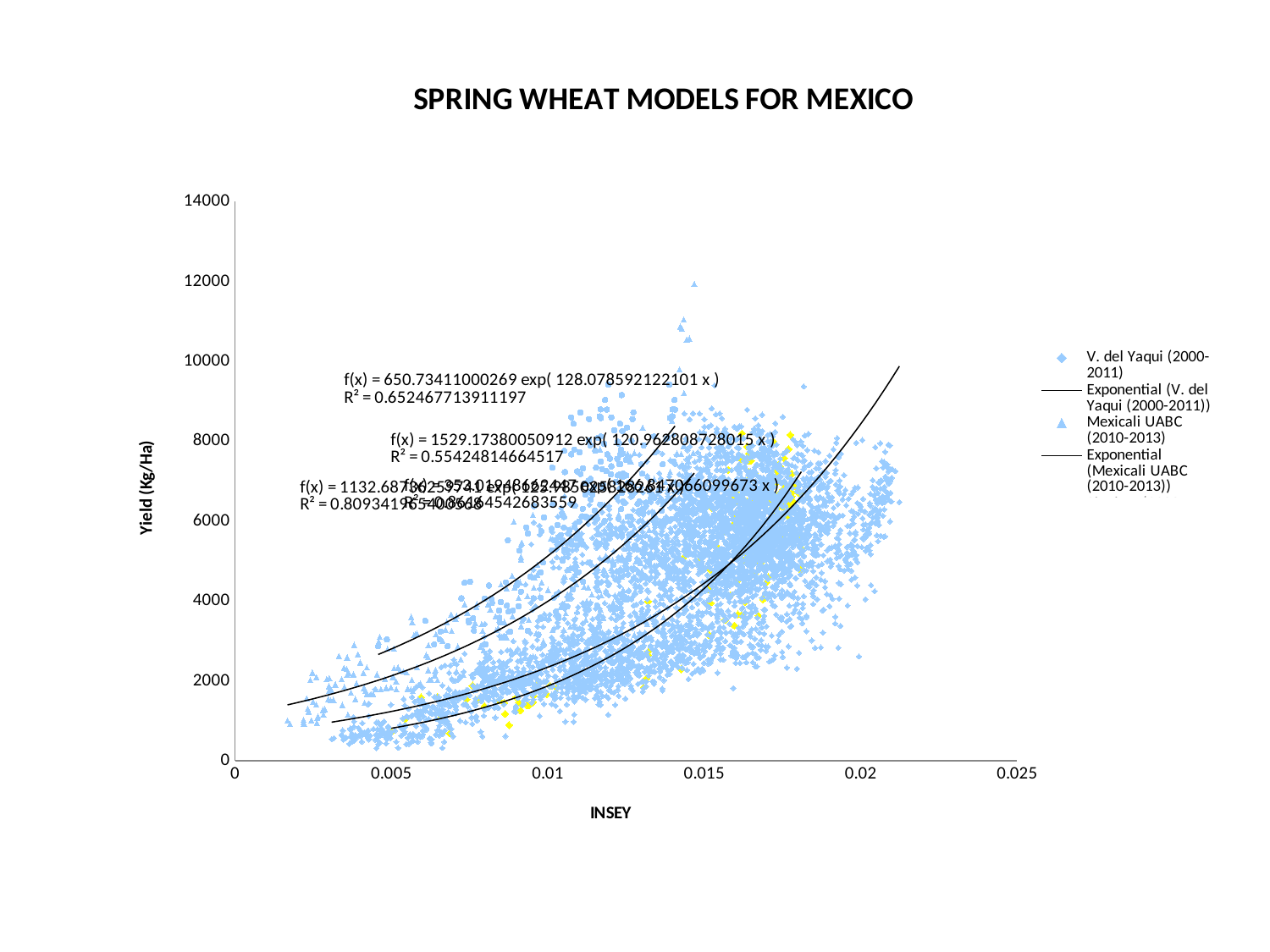
What is the highest tick value shown on the x axis? 0.025 What is the R² value printed for the model f(x) = 1529.17380050912 exp( 120.962808728015 x )? 0.55424814664517 What is the label of the y axis? Yield (Kg/Ha) Which years does the legend give for the Mexicali UABC series? 2010-2013 What is the label of the x axis? INSEY Does yield generally rise or fall as INSEY increases along the x axis? Rise What kind of chart is shown on the slide? Scatter chart What is the title of the chart? SPRING WHEAT MODELS FOR MEXICO What is the highest tick value shown on the y axis? 14000 Is the highest plotted yield value greater or less than 10000? greater What is the R² value printed for the model f(x) = 650.73411000269 exp( 128.078592122101 x )? 0.652467713911197 Which model has the higher printed R²: the one with coefficient 650.73411000269 or the one with coefficient 1529.17380050912? 650.73411000269